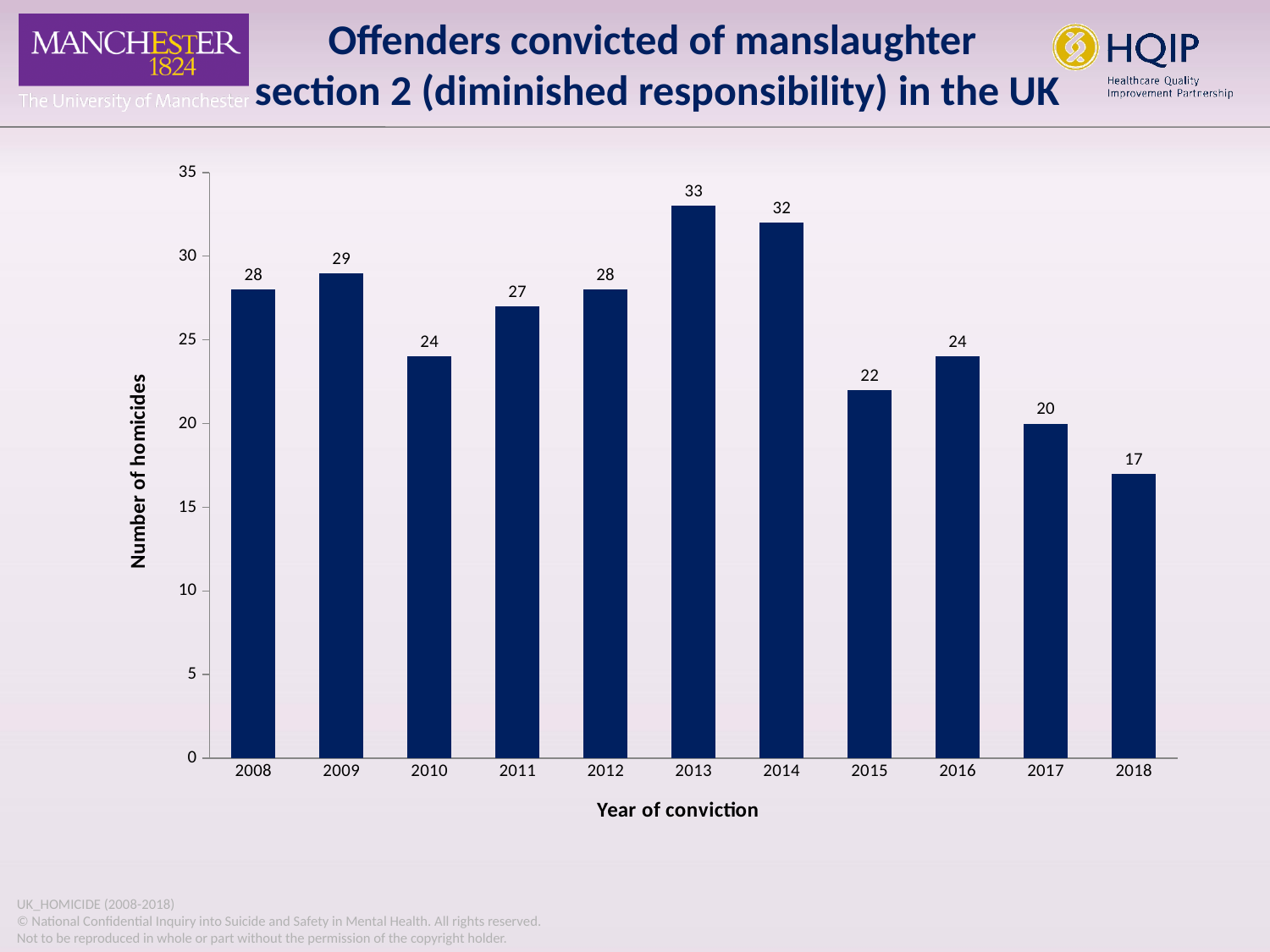
Is the value for 2017 greater or less than 25? less Which year has the highest number of homicides? 2013 What is the label of the x axis? Year of conviction What is the number of homicides for 2010? 24 What is the difference in the number of homicides between 2009 and 2010? 5 Which year has more homicides, 2014 or 2015? 2014 What is the number of homicides for 2013? 33 What is the number of homicides for 2018? 17 What kind of chart is shown on the slide? Bar chart Which year has the lowest number of homicides? 2018 How many years are shown on the x axis? 11 What is the difference in the number of homicides between 2013 and 2018? 16